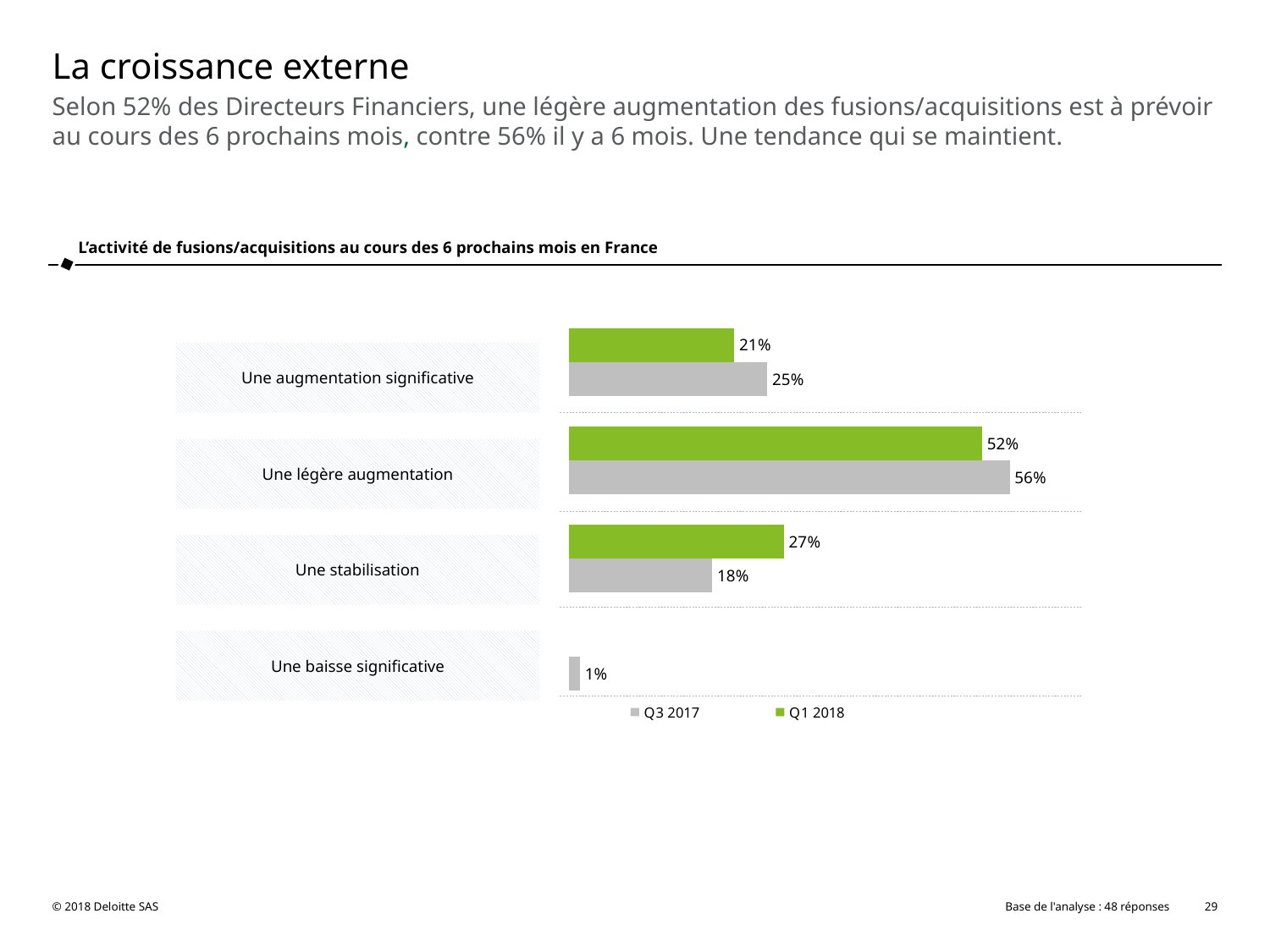
What is the Q3 2017 value for "Une baisse significative"? 1% Which category has the highest Q1 2018 value? Une légère augmentation For "Une augmentation significative", which is larger: the Q3 2017 value or the Q1 2018 value? Q3 2017 What is the Q1 2018 value for "Une légère augmentation"? 52% How many categories are shown on the chart? 4 Which category has the lowest Q3 2017 value? Une baisse significative How many series does the legend list? 2 What is the Q1 2018 value for "Une stabilisation"? 27% What is the Q3 2017 value for "Une augmentation significative"? 25% What is the difference between the Q3 2017 and Q1 2018 values for "Une stabilisation"? 9% What kind of chart is shown on the slide? bar chart What is the difference between the Q3 2017 and Q1 2018 values for "Une légère augmentation"? 4%